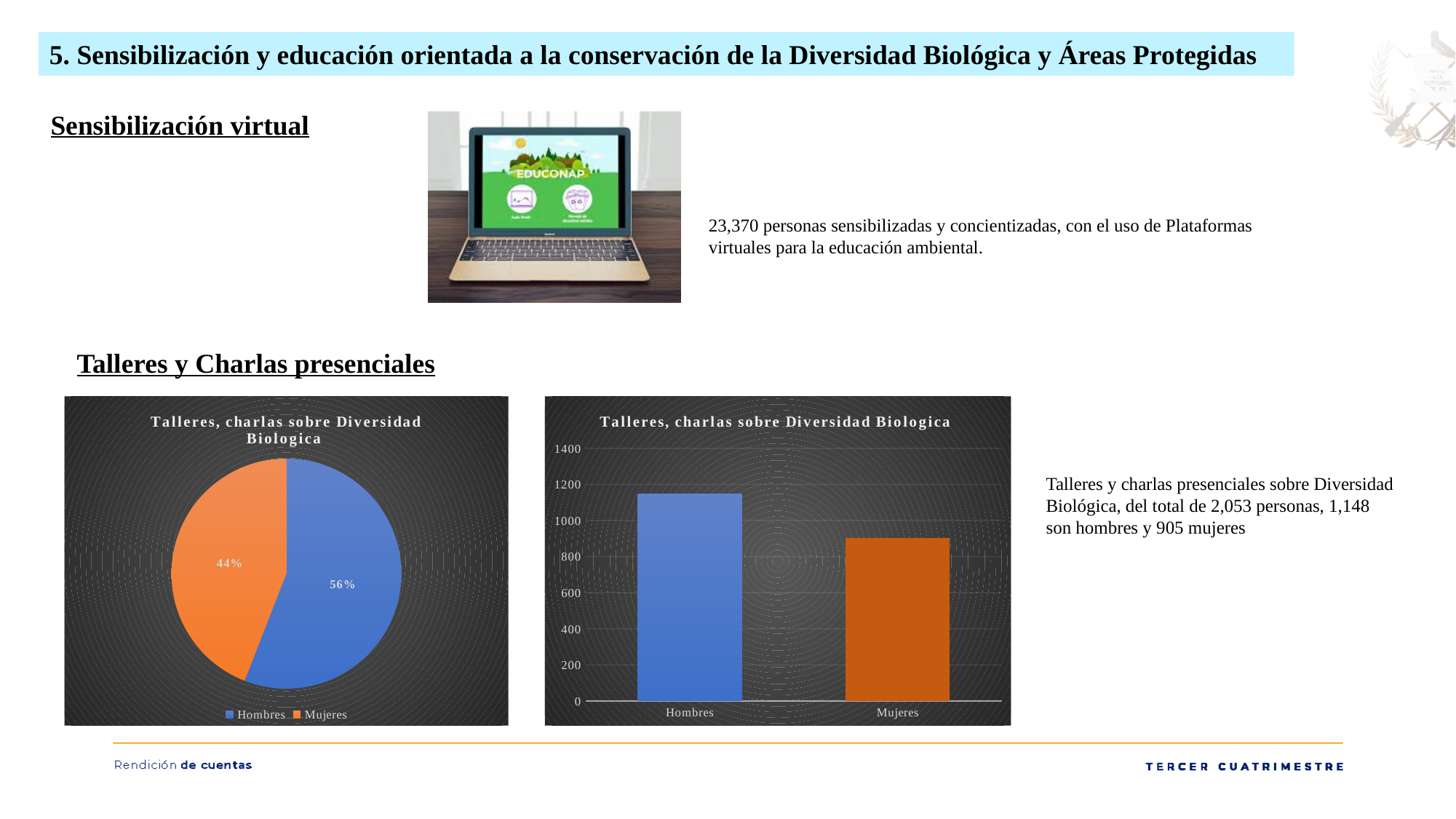
How many entries does the legend of the pie chart on the left list? 2 What kind of chart is the chart on the left? Pie chart In the pie chart on the left, what share of the pie does Mujeres take? 44% In the pie chart on the left, which slice is the smallest? Mujeres In the bar chart on the right, is the value for Hombres greater or less than 1000? greater In the bar chart on the right, is the value for Mujeres greater or less than 1000? less In the pie chart on the left, which slice is the largest? Hombres In the pie chart on the left, what is the difference in percentage points between the Hombres and Mujeres slices? 12 percentage points How many categories are shown on the x axis of the bar chart on the right? 2 What kind of chart is the chart on the right? Bar chart In the pie chart on the left, what share of the pie does Hombres take? 56% In the bar chart on the right, which bar is taller, Hombres or Mujeres? Hombres